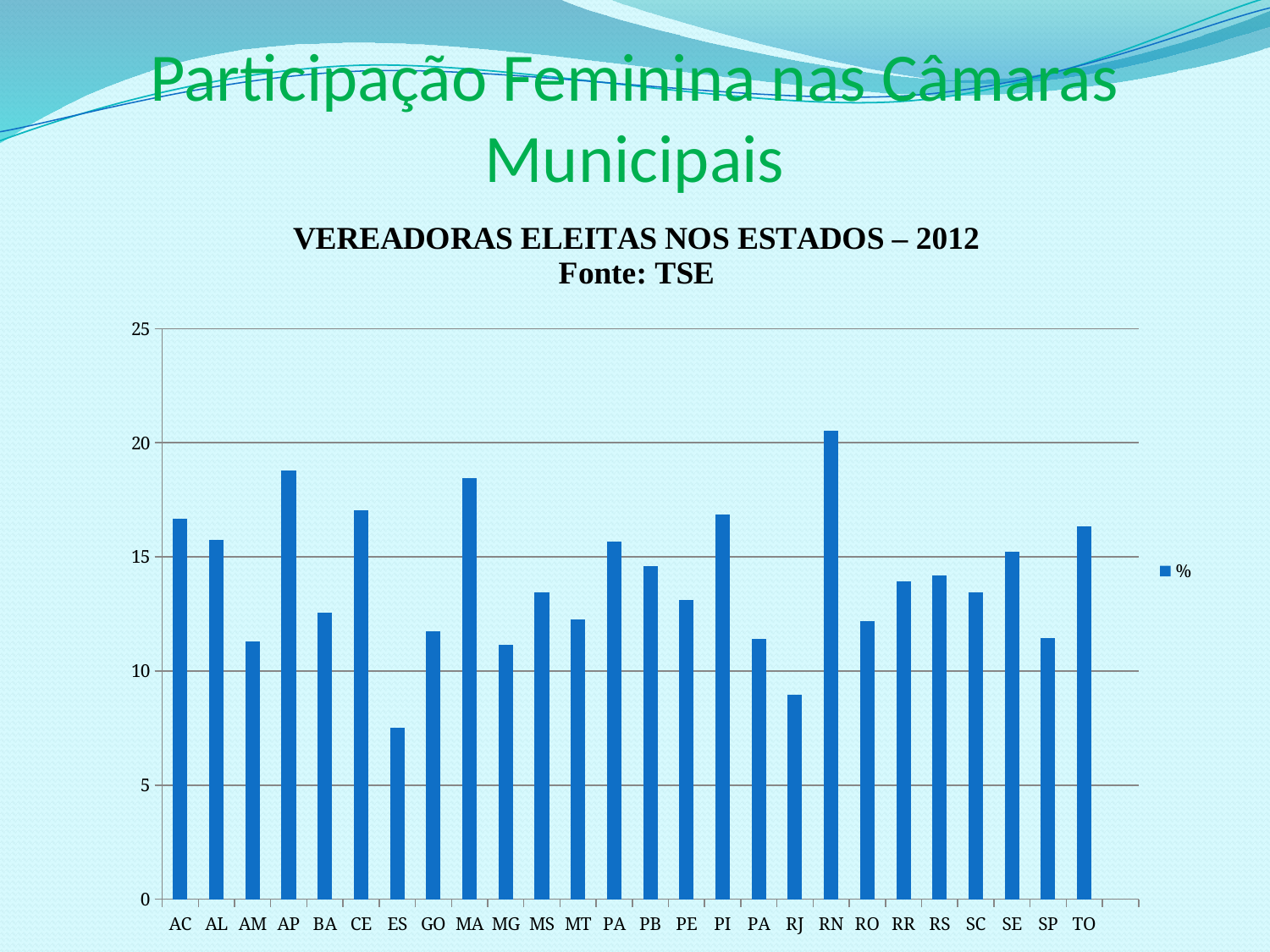
Which has the larger value, AP or BA? AP Which has the larger value, ES or GO? GO Which state has the highest value in the chart? RN What kind of chart is shown on the slide? bar chart Is the value for RJ greater or less than 10? less Is the value for RN greater or less than 20? greater Is the value for AP greater or less than 15? greater What is the title of the chart? VEREADORAS ELEITAS NOS ESTADOS – 2012 Fonte: TSE How many series does the legend list? 1 Which state has the lowest value in the chart? ES